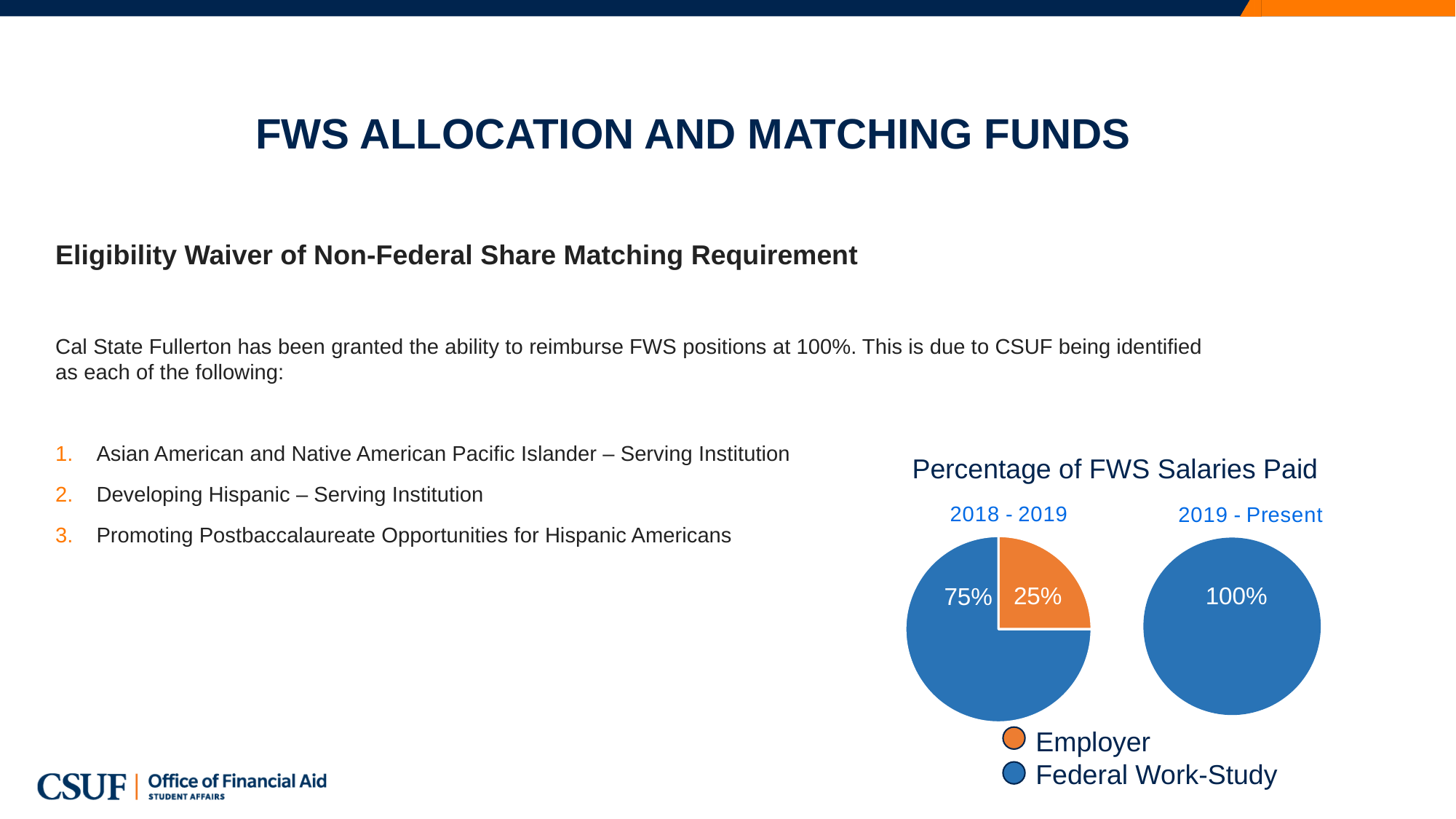
In the 2018 - 2019 pie chart, what percentage of FWS salaries was paid by Federal Work-Study? 75% In the 2018 - 2019 pie chart, what percentage of FWS salaries was paid by the Employer? 25% In the 2018 - 2019 pie chart, what is the difference between the Federal Work-Study share and the Employer share? 50% Is the Federal Work-Study share larger in the 2018 - 2019 chart or the 2019 - Present chart? 2019 - Present In the 2019 - Present pie chart, what percentage of FWS salaries was paid by Federal Work-Study? 100% What type of chart is used to show the Percentage of FWS Salaries Paid? Pie chart In the 2018 - 2019 pie chart, which source paid the larger share of FWS salaries? Federal Work-Study How many slices does the 2018 - 2019 pie chart have? 2 In the 2018 - 2019 pie chart, which source paid the smaller share of FWS salaries? Employer How many series does the legend list for the Percentage of FWS Salaries Paid charts? 2 Which colour represents Employer in the pie chart legend? Orange What is the title of the pie charts on the slide? Percentage of FWS Salaries Paid